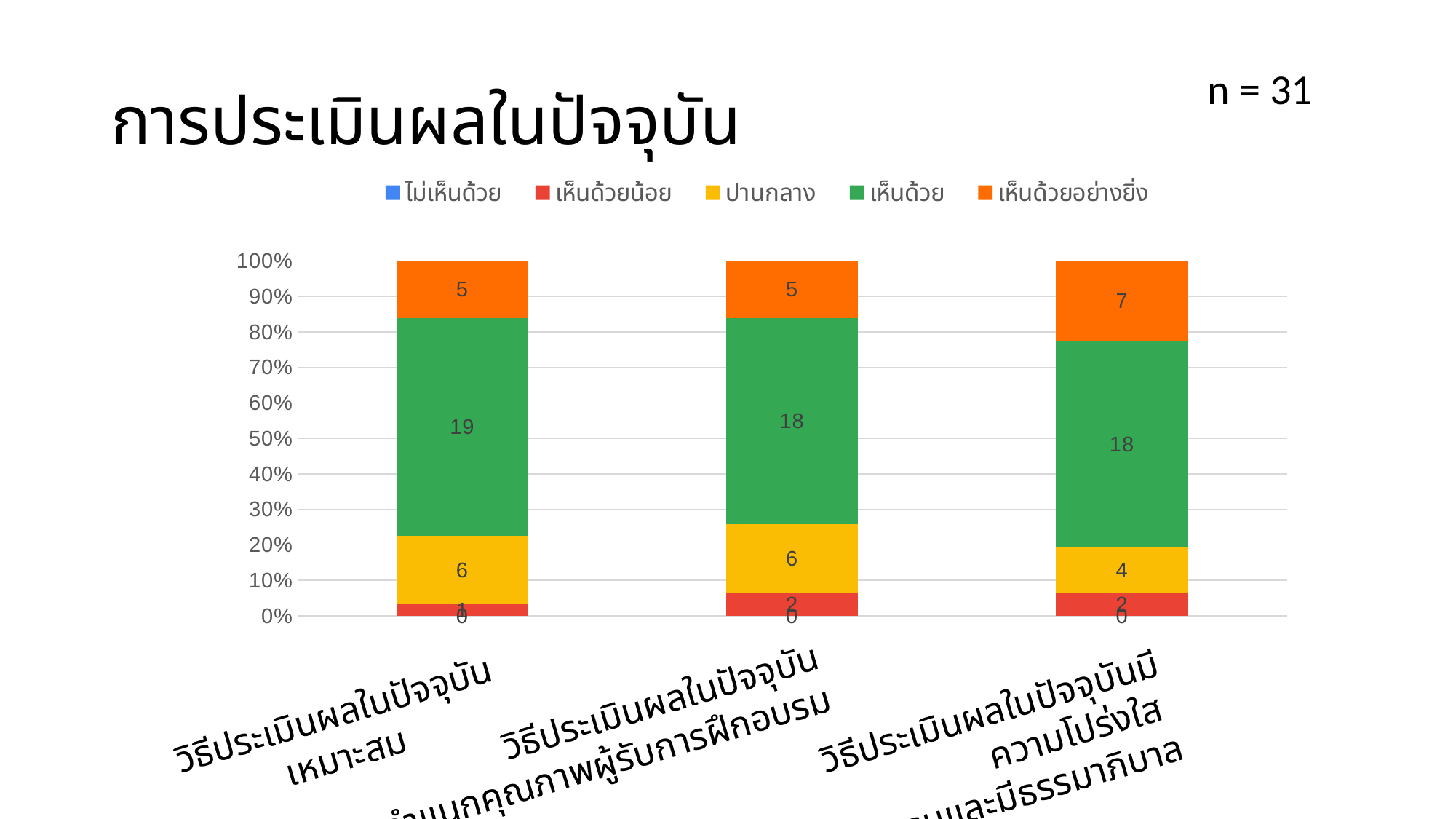
What is the title of the chart? การประเมินผลในปัจจุบัน What is the value of เห็นด้วย for the category วิธีประเมินผลในปัจจุบันเหมาะสม? 19 How many series does the legend list? 5 How many categories (bars) are plotted on the chart? 3 Which category has the highest value for เห็นด้วยอย่างยิ่ง? The third (rightmost) bar, วิธีประเมินผลในปัจจุบันมีความโปร่งใส What is the difference between the เห็นด้วย value of the first bar and the เห็นด้วย value of the second bar? 1 What is the value of เห็นด้วยอย่างยิ่ง for the third (rightmost) bar? 7 What is the value of ปานกลาง for the second (middle) bar? 6 Which category has the lowest value for ปานกลาง? The third (rightmost) bar, วิธีประเมินผลในปัจจุบันมีความโปร่งใส What is the total of all segments in the first bar (วิธีประเมินผลในปัจจุบันเหมาะสม)? 31 What is the value of เห็นด้วยน้อย for the category วิธีประเมินผลในปัจจุบันเหมาะสม? 1 What kind of chart is shown on the slide? Stacked bar chart